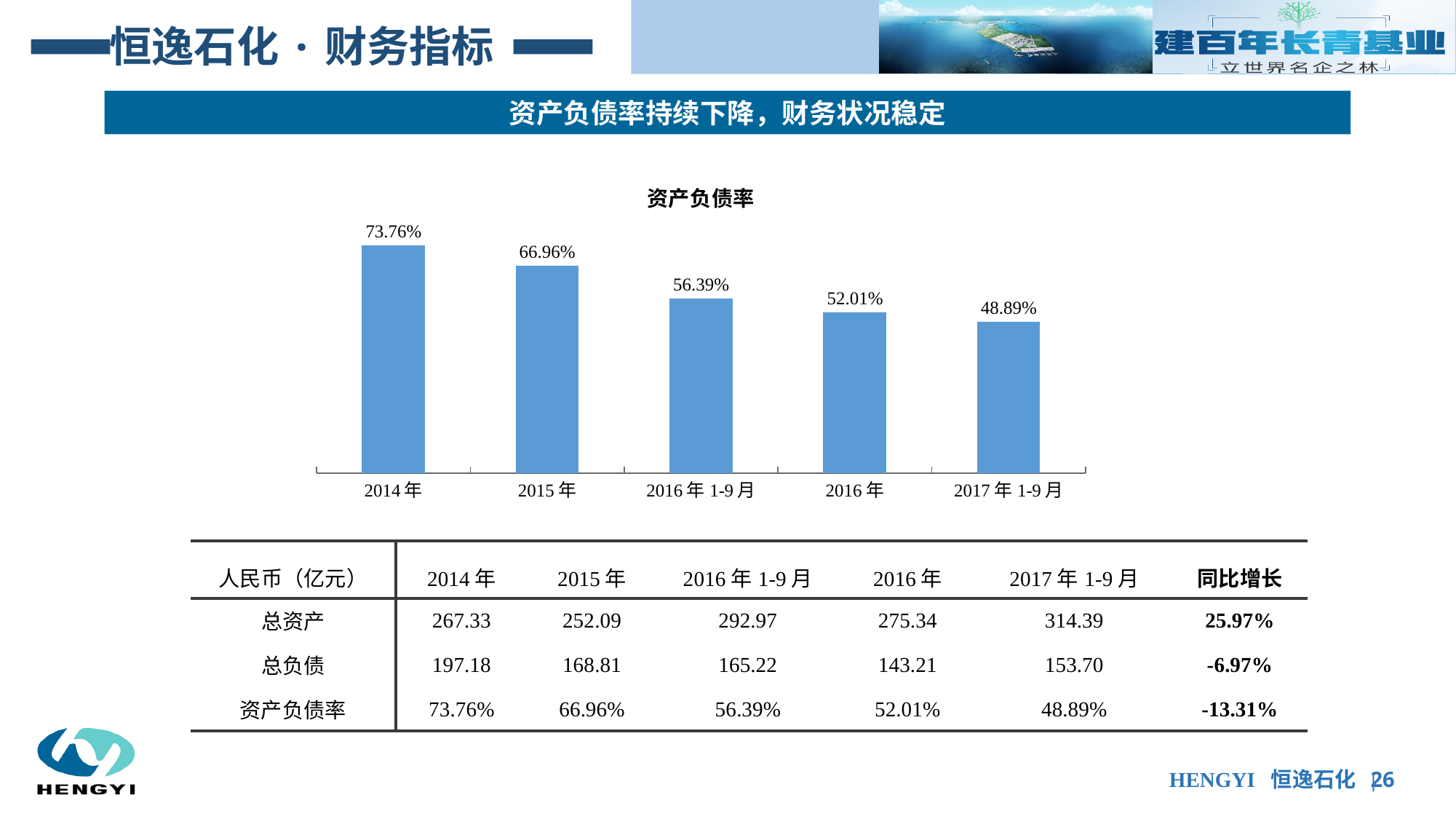
How many categories are shown on the x axis of the chart? 5 What kind of chart is shown on the slide? Bar chart What is the 资产负债率 for 2014年? 73.76% Which category has the lowest 资产负债率? 2017年 1-9月 What is the difference between the 资产负债率 for 2014年 and 2017年 1-9月? 24.87% What is the title of the chart? 资产负债率 Do the values rise or fall from left to right along the x axis? Fall Which is larger, the 资产负债率 for 2015年 or for 2016年? 2015年 Which category has the highest 资产负债率? 2014年 What is the difference between the 资产负债率 for 2015年 and 2016年? 14.95% What is the 资产负债率 for 2016年 1-9月? 56.39% What is the 资产负债率 for 2017年 1-9月? 48.89%